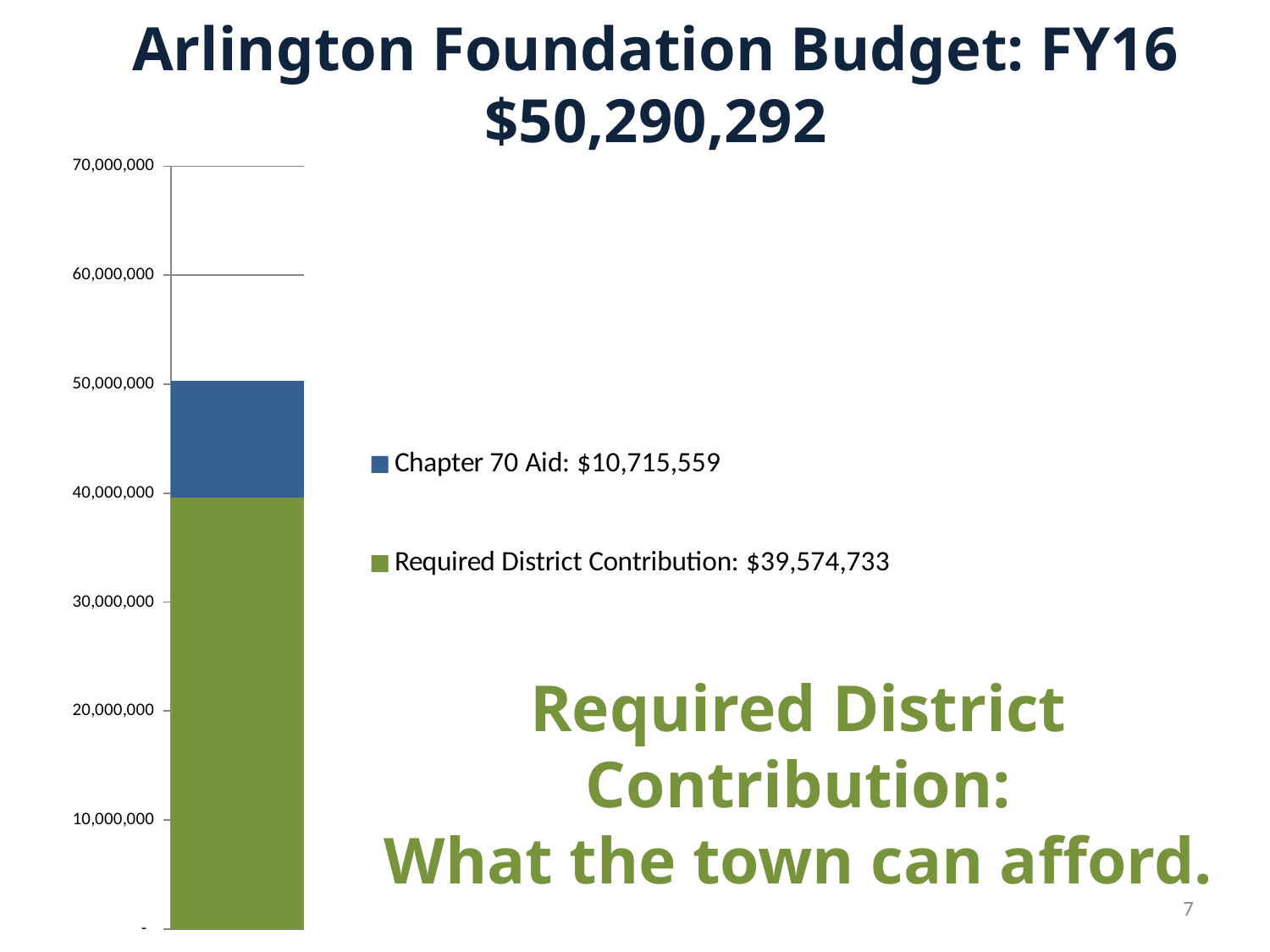
What is the value of Chapter 70 Aid according to the legend? $10,715,559 Is the Required District Contribution segment greater or less than 30,000,000 on the axis? greater How many series does the legend list? 2 What is the value of the Required District Contribution according to the legend? $39,574,733 What colour represents Chapter 70 Aid in the chart? Blue How many bars are plotted in the chart? 1 What is the difference between the Required District Contribution and Chapter 70 Aid? $28,859,174 What kind of chart is shown on the slide? Stacked bar chart What is the total of the stacked bar, as given in the slide title? $50,290,292 Which series is larger, Chapter 70 Aid or Required District Contribution? Required District Contribution Is the top of the stacked bar greater or less than 60,000,000 on the axis? less Which series makes up the smallest part of the stacked bar? Chapter 70 Aid